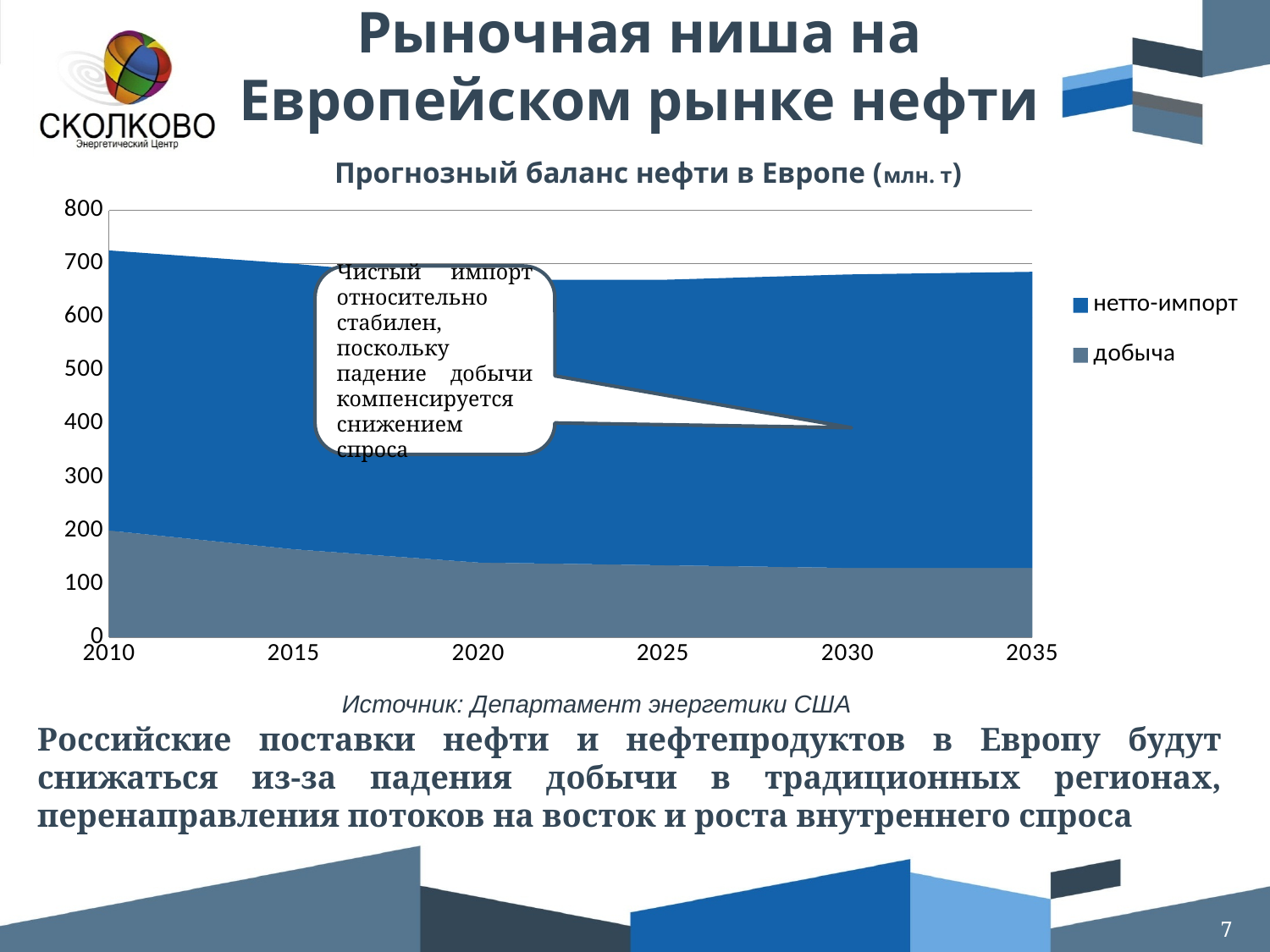
What kind of chart is shown on the slide? Stacked area chart What is the title of the chart? Прогнозный баланс нефти в Европе (млн. т) How many series does the chart legend list? 2 Is the value for добыча in 2010 greater or less than 300? less Is the value for добыча in 2035 greater or less than 200? less What are the two series named in the chart legend? нетто-импорт and добыча Is the total of the stacked areas in 2010 greater or less than 600? greater Which year on the x axis has the highest value for добыча? 2010 Does the value for добыча rise or fall from 2010 to 2035? Fall How many years are labelled on the x axis of the chart? 6